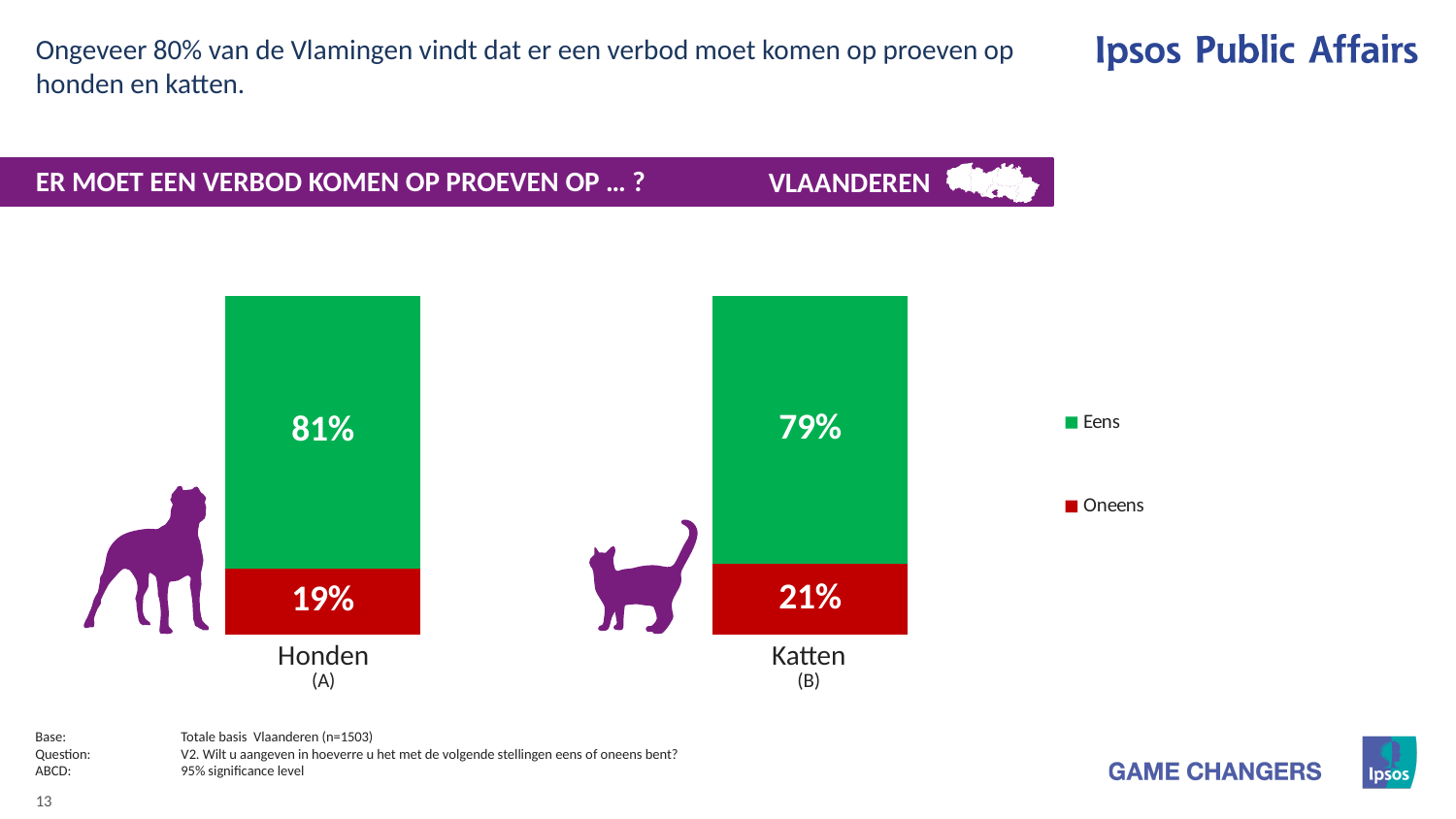
What is the total of the stacked bar for Katten? 100% What is the Oneens value for Honden? 19% What kind of chart is shown on the slide? Stacked bar chart Which category has the higher Eens share, Honden or Katten? Honden What is the difference between the Eens values for Honden and Katten? 2% Which colour represents Oneens in the legend? Red Which category has the highest Oneens share? Katten What is the Eens value for Katten? 79% What percentage of respondents disagree (Oneens) with a ban on testing on cats (Katten)? 21% How many series does the legend list? 2 How many categories are shown on the x axis? 2 What percentage of respondents agree (Eens) with a ban on testing on dogs (Honden)? 81%